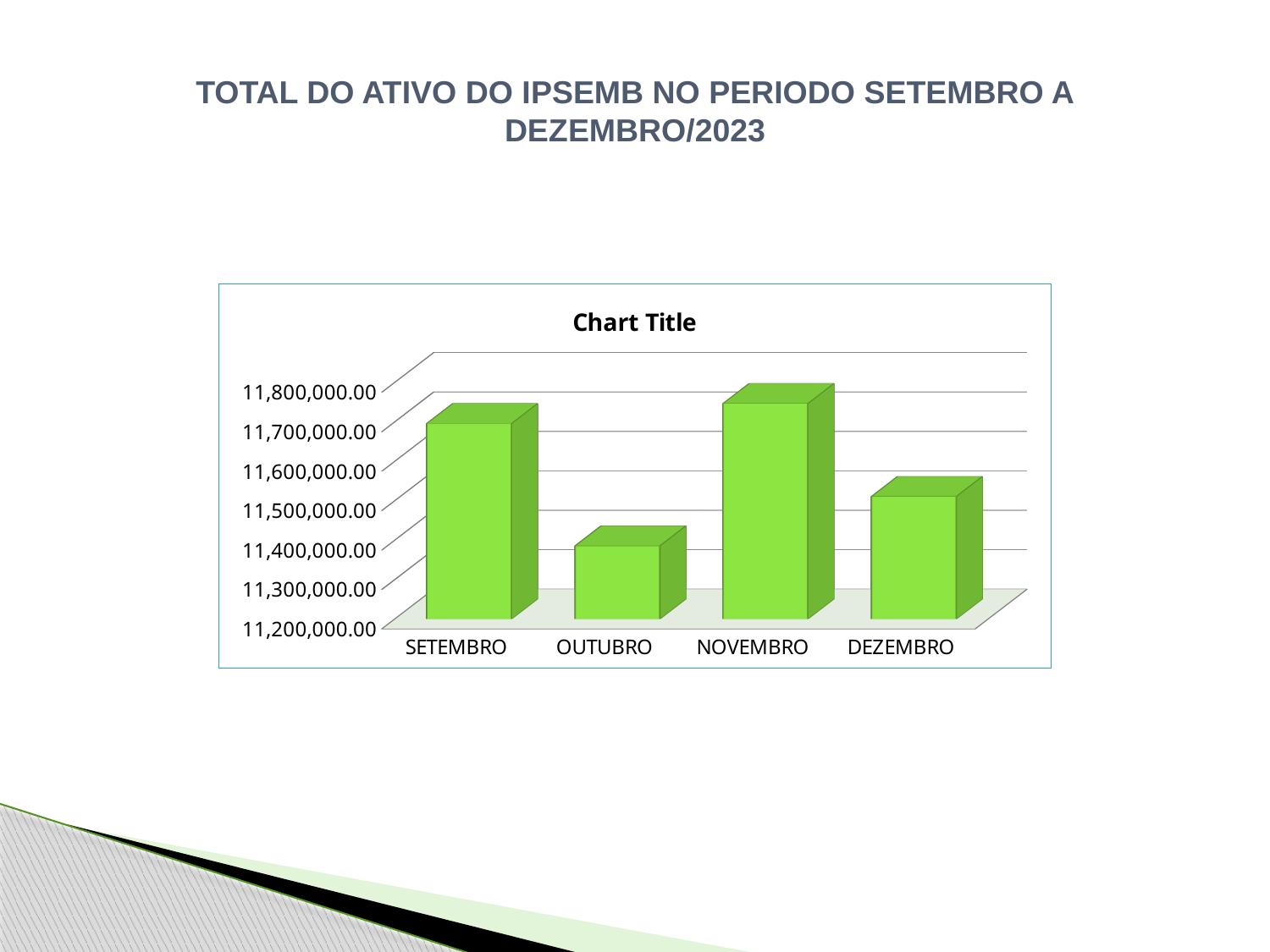
Which is larger, the value for OUTUBRO or the value for DEZEMBRO? DEZEMBRO Is the value for SETEMBRO greater or less than 11,600,000.00? greater Which month has the lowest value on the chart? OUTUBRO Is the value for NOVEMBRO greater or less than 11,600,000.00? greater Is the value for DEZEMBRO greater or less than 11,600,000.00? less Which is larger, the value for SETEMBRO or the value for DEZEMBRO? SETEMBRO Which month has the highest value on the chart? NOVEMBRO What kind of chart is shown on the slide? Bar chart How many categories (months) are plotted on the chart? 4 What title is printed inside the chart area? Chart Title What colour are the bars in the chart? Green